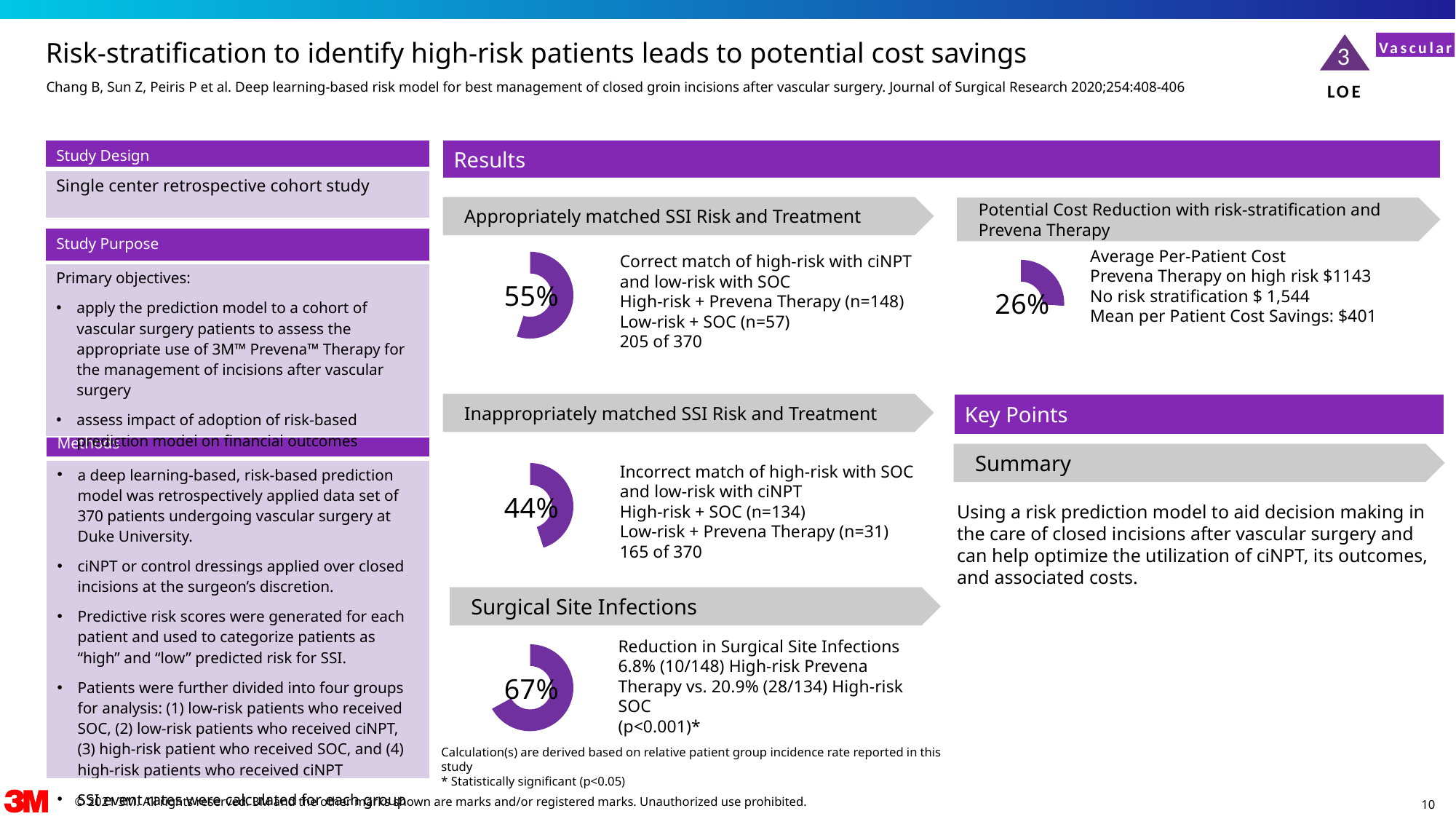
What is the difference in percentage points between the "Appropriately matched" donut chart (55%) and the "Inappropriately matched" donut chart (44%)? 11 percentage points What percentage is shown in the donut chart under "Potential Cost Reduction with risk-stratification and Prevena Therapy"? 26% Which is larger: the percentage in the "Appropriately matched SSI Risk and Treatment" donut chart or the "Inappropriately matched SSI Risk and Treatment" donut chart? Appropriately matched SSI Risk and Treatment (55%) What percentage is shown in the donut chart under "Surgical Site Infections"? 67% What percentage is shown in the donut chart under "Inappropriately matched SSI Risk and Treatment"? 44% Which donut chart on the slide shows the highest percentage? Surgical Site Infections (67%) What colour is the filled portion of the donut charts on the slide? Purple Is the value in the "Potential Cost Reduction" donut chart greater or less than 50%? less How many donut charts are shown in the Results section of the slide? 4 What percentage is shown in the donut chart under "Appropriately matched SSI Risk and Treatment"? 55% What kind of chart is used to display the 55% value under "Appropriately matched SSI Risk and Treatment"? Donut chart Which donut chart on the slide shows the lowest percentage? Potential Cost Reduction with risk-stratification and Prevena Therapy (26%)